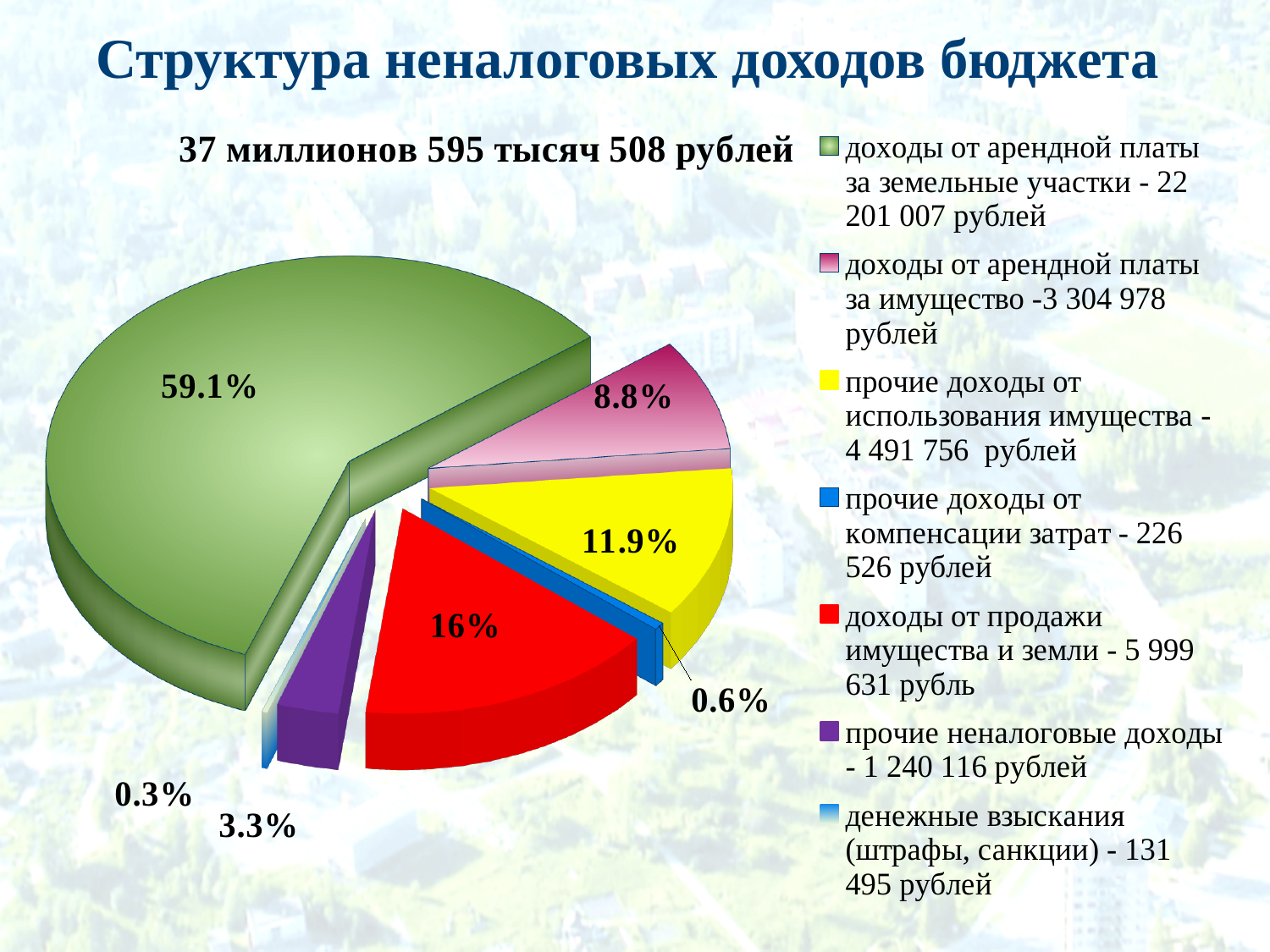
Which category has the smallest share of the pie? денежные взыскания (штрафы, санкции) What is the difference in percentage points between the red slice (16%) and the yellow slice (11.9%)? 4.1 What total amount is stated above the pie chart? 37 миллионов 595 тысяч 508 рублей What kind of chart is shown on the slide? pie chart What percentage is shown for доходы от продажи имущества и земли (the red slice)? 16% How many slices does the pie chart have? 7 What share of the pie is labelled for доходы от арендной платы за земельные участки (the green slice)? 59.1% Which category has the largest share of the pie? доходы от арендной платы за земельные участки According to the legend, what is the ruble amount for доходы от продажи имущества и земли? 5 999 631 рубль What percentage is shown for доходы от арендной платы за имущество (the pink slice)? 8.8% What percentage is shown for прочие доходы от использования имущества (the yellow slice)? 11.9% Which is larger: the share for прочие неналоговые доходы or the share for прочие доходы от компенсации затрат? прочие неналоговые доходы